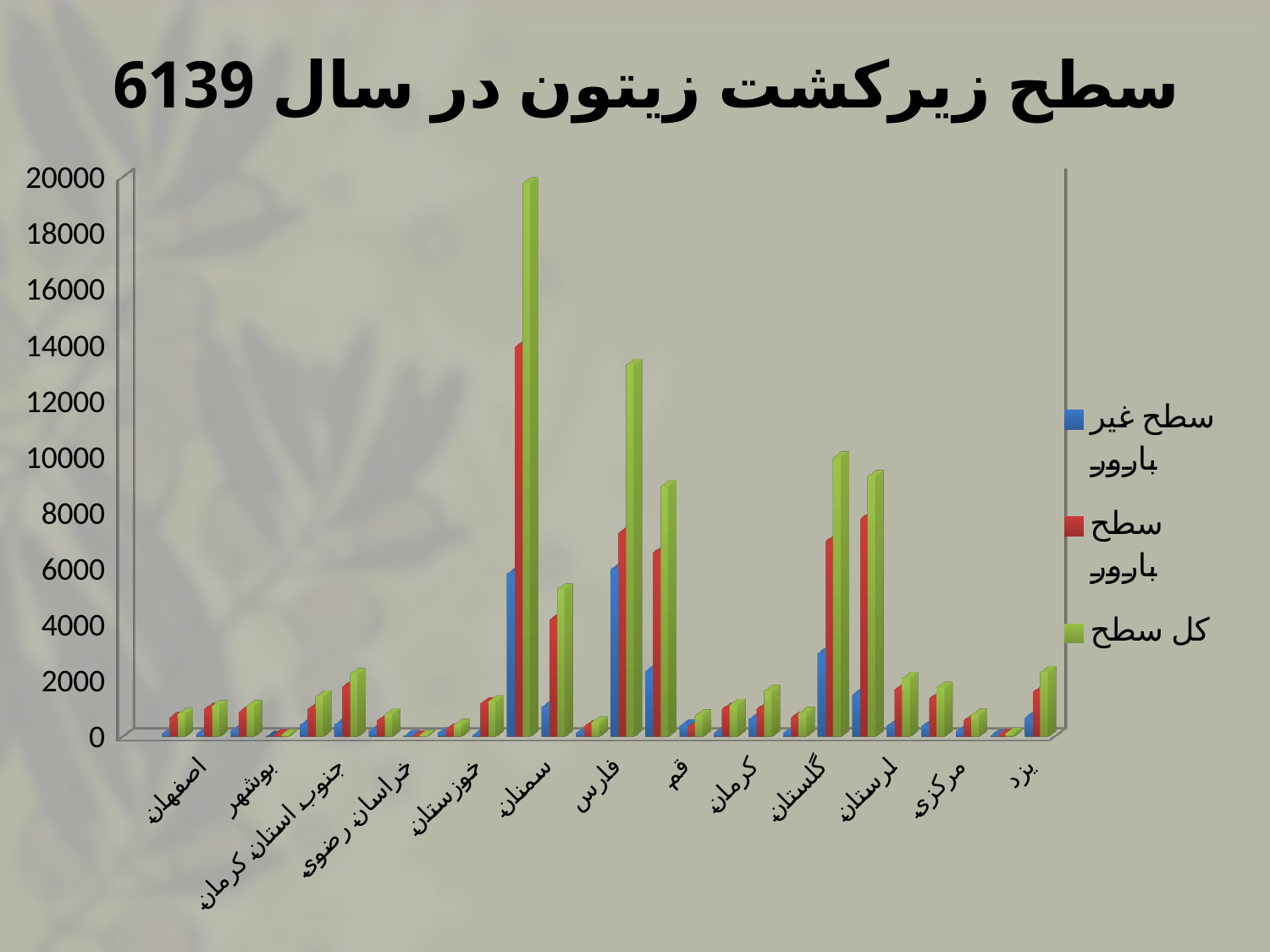
In the tallest group of bars, which series is larger, سطح غیر بارور or کل سطح? کل سطح Which colour represents کل سطح in the legend? green Which series reaches the highest value on the chart? کل سطح How many series does the legend list? 3 What kind of chart is shown on the slide? bar chart Is the tallest bar for کل سطح greater or less than 18000? greater Is the tallest bar for سطح غیر بارور greater or less than 4000? greater Is the tallest bar for سطح بارور greater or less than 12000? greater What are the three series named in the legend? سطح غیر بارور, سطح بارور, کل سطح What is the title of the chart? سطح زیرکشت زیتون در سال 6139